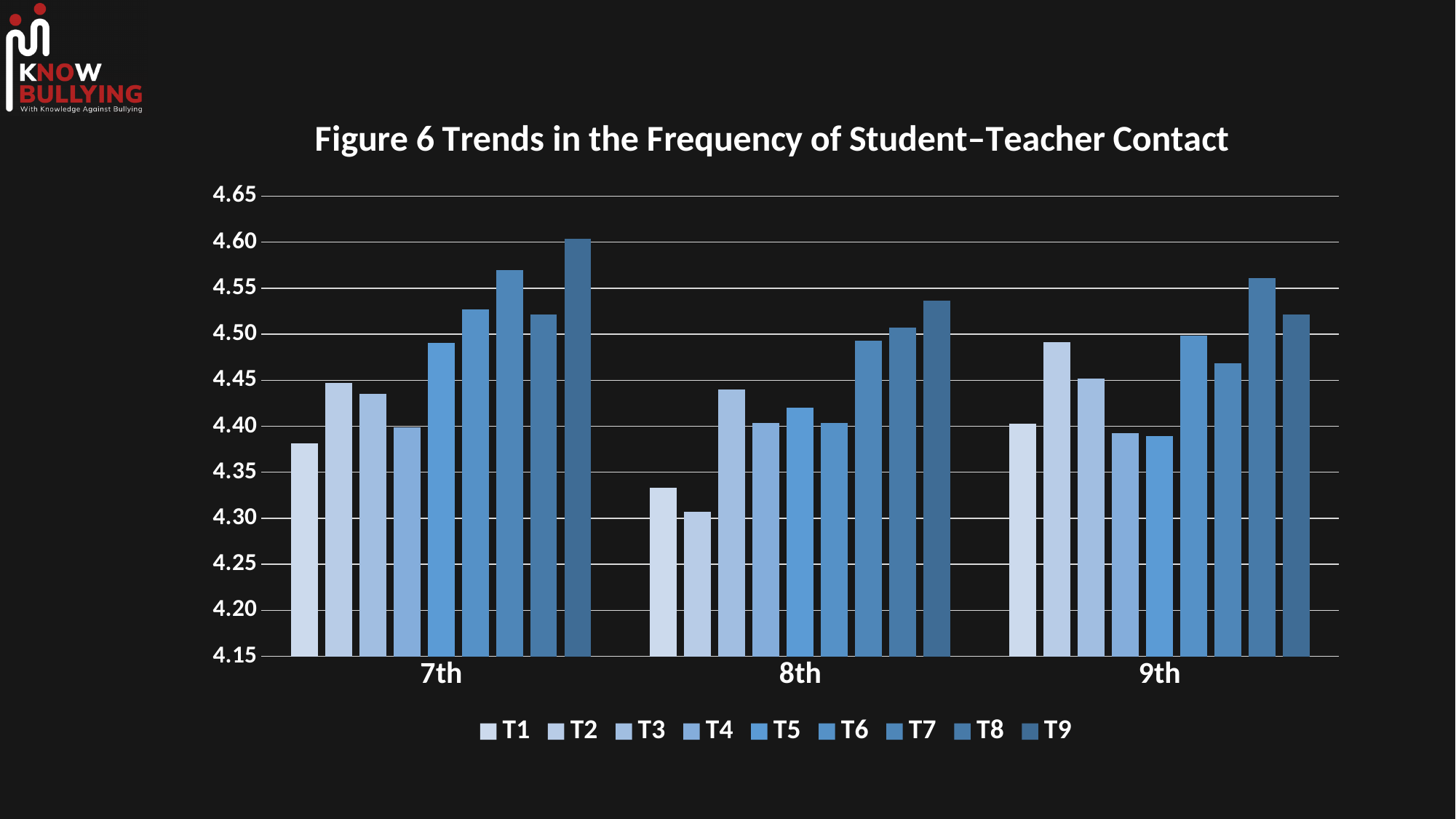
Which series has the highest value for 7th grade? T9 Which series has the lowest value for 8th grade? T2 Which series has the highest value for 9th grade? T8 Is the value for T9 in 7th grade greater or less than 4.55? greater Which is larger: the T7 value for 7th grade or the T7 value for 8th grade? 7th grade Is the value for T8 in 9th grade greater or less than 4.50? greater How many grade categories are shown on the x axis? 3 What is the title of the chart? Figure 6 Trends in the Frequency of Student–Teacher Contact Is the value for T1 in 8th grade greater or less than 4.35? less How many series does the legend list? 9 Which is larger for 9th grade: T2 or T4? T2 What kind of chart is shown on the slide? bar chart